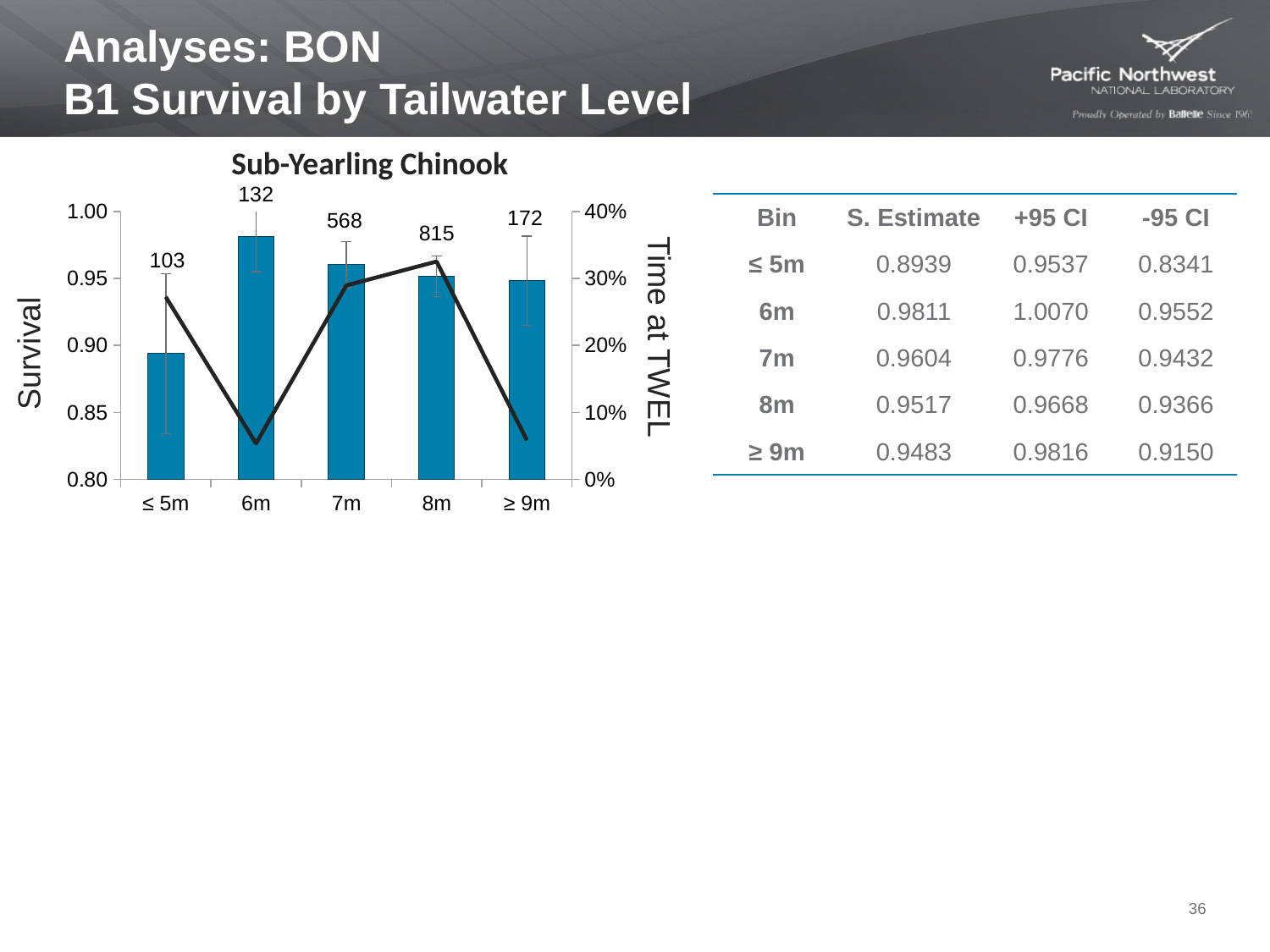
What kind of chart is the Sub-Yearling Chinook chart? Bar chart with a line overlay Is the Time at TWEL line value for 6m greater or less than 10%? less Which tailwater bin has the tallest survival bar in the Sub-Yearling Chinook chart? 6m Is the Time at TWEL line value for ≤ 5m greater or less than 20%? greater What is the label of the right-hand y axis in the Sub-Yearling Chinook chart? Time at TWEL What is the difference between the numbers printed above the 8m and 7m bars? 247 What number is printed above the 8m bar in the Sub-Yearling Chinook chart? 815 What number is printed above the 7m bar in the Sub-Yearling Chinook chart? 568 Which has the higher survival bar, ≤ 5m or ≥ 9m? ≥ 9m How many tailwater bins are shown on the x axis of the Sub-Yearling Chinook chart? 5 Which tailwater bin has the shortest survival bar in the Sub-Yearling Chinook chart? ≤ 5m Is the Time at TWEL line value for ≥ 9m greater or less than 10%? less